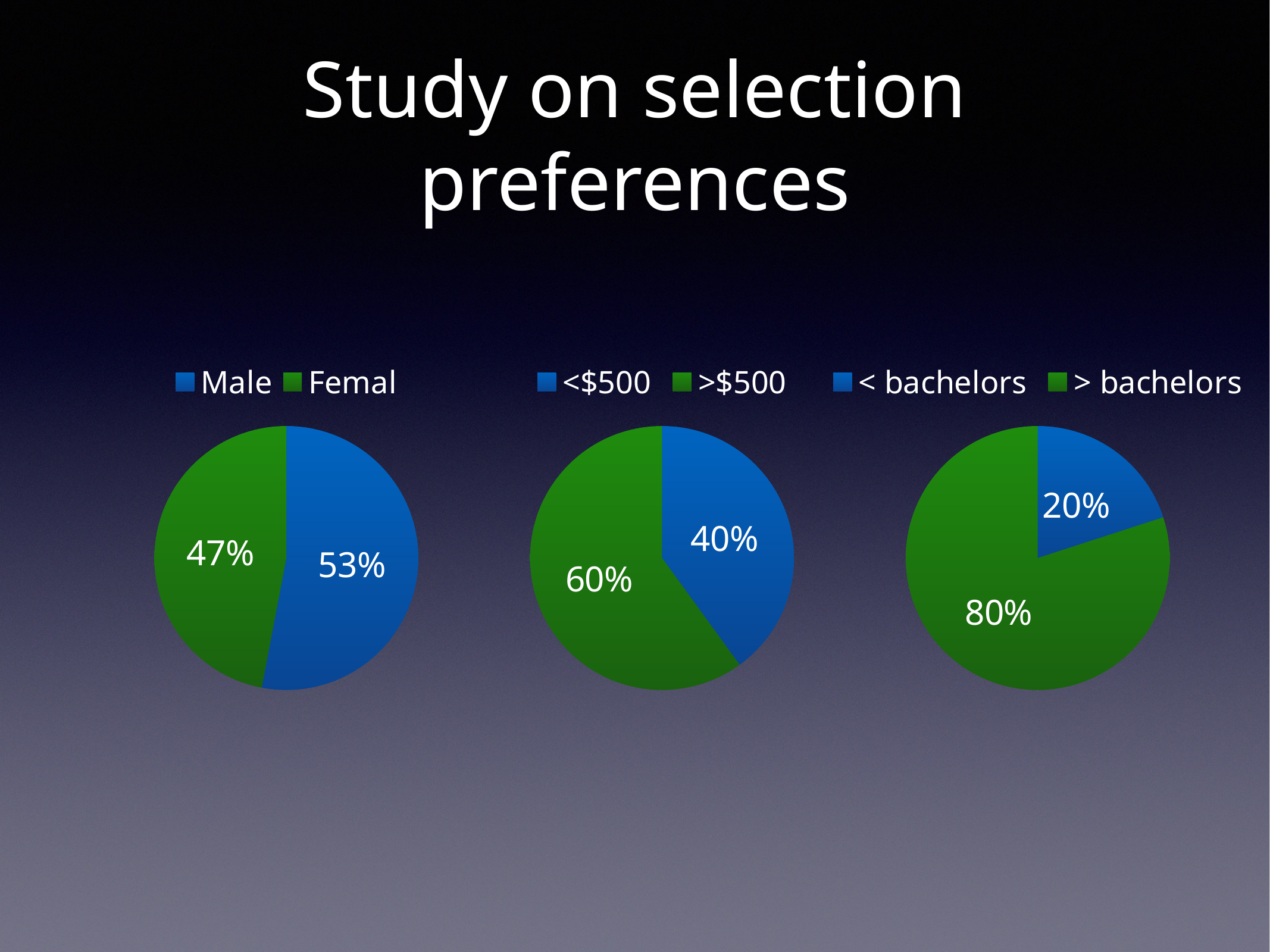
In the right pie chart (< bachelors/> bachelors), what is the difference between the > bachelors and < bachelors values? 60% How many pie charts are shown on the slide? 3 In the left pie chart (Male/Femal), what is the value for Femal? 47% In the middle pie chart (<$500/>$500), what is the value for <$500? 40% In the left pie chart (Male/Femal), what is the difference between the Male and Femal values? 6% In the middle pie chart (<$500/>$500), which category is the smallest? <$500 What type of chart is used for the Male/Femal data on the left? Pie chart In the right pie chart (< bachelors/> bachelors), what is the value for < bachelors? 20% In the left pie chart (Male/Femal), what is the value for Male? 53% In the right pie chart (< bachelors/> bachelors), which category is the largest? > bachelors In the middle pie chart (<$500/>$500), what is the value for >$500? 60% In the middle pie chart (<$500/>$500), which is larger, <$500 or >$500? >$500